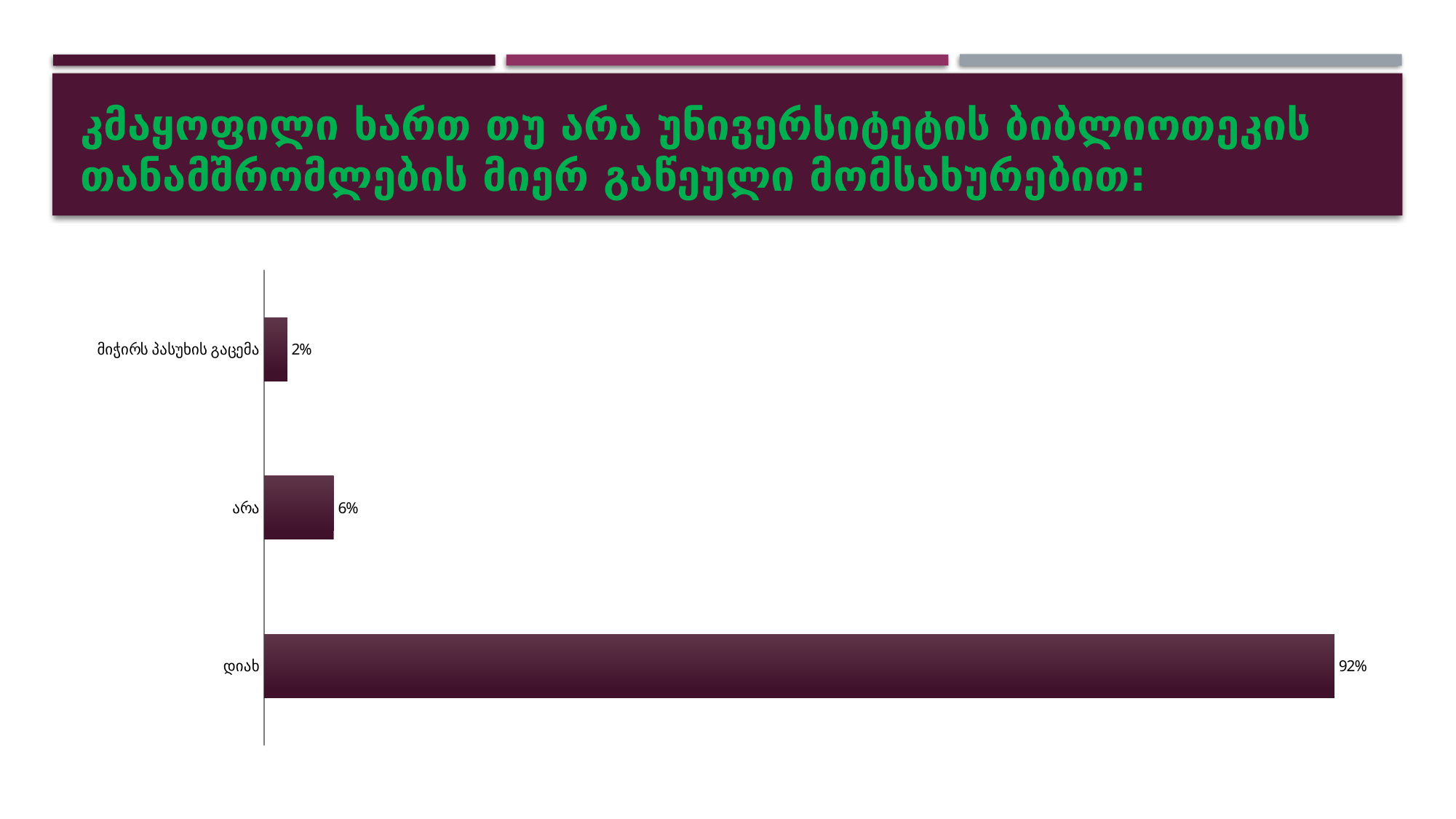
Which is larger, the value for არა or the value for მიჭირს პასუხის გაცემა? არა What is the value for დიახ? 92% Which category has the highest value? დიახ What is the value for არა? 6% Are the bars in the chart horizontal or vertical? horizontal What kind of chart is shown on the slide? bar chart Which category has the lowest value? მიჭირს პასუხის გაცემა What is the total of the three values shown in the chart? 100% What is the difference between the values for დიახ and არა? 86% What is the difference between the values for არა and მიჭირს პასუხის გაცემა? 4% What is the value for მიჭირს პასუხის გაცემა? 2% How many categories are shown in the chart? 3